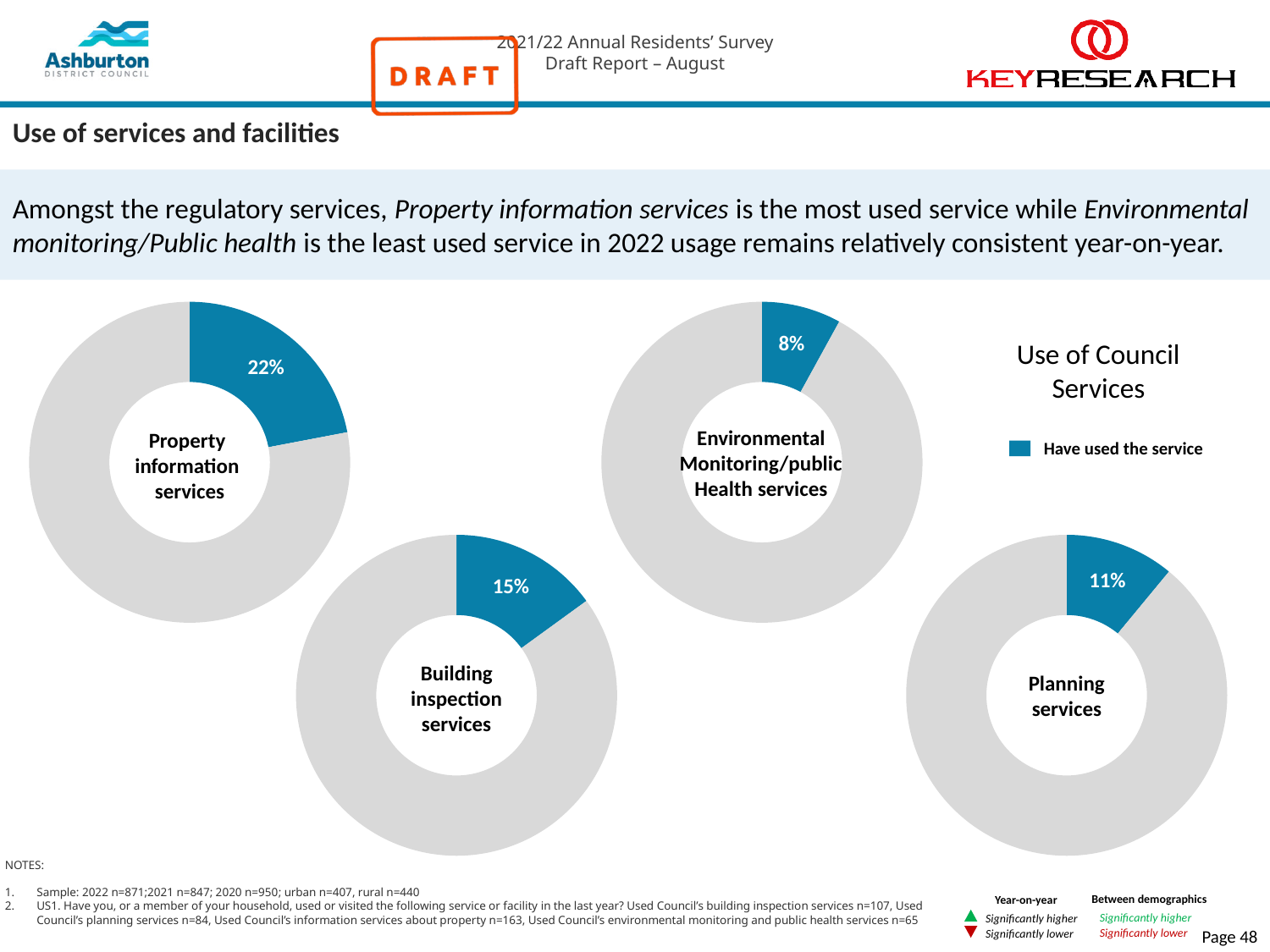
In the Planning services donut chart, what percentage have used the service? 11% Across the four donut charts, which service has the highest percentage of residents who have used it? Property information services Across the four donut charts, which service has the lowest percentage of residents who have used it? Environmental Monitoring/public Health services Which is larger: the percentage in the Building inspection services chart or the percentage in the Planning services chart? Building inspection services In the Environmental Monitoring/public Health services donut chart, what percentage have used the service? 8% What is the legend entry shown next to the blue colour in the 'Use of Council Services' legend? Have used the service In the Property information services donut chart, what percentage have used the service? 22% What is the difference in percentage points between the Building inspection services chart and the Environmental Monitoring/public Health services chart? 7 How many donut charts are shown on the slide? 4 What type of chart is used to show use of each Council service on the slide? Donut (pie) chart What is the difference in percentage points between the Property information services chart and the Planning services chart? 11 In the Building inspection services donut chart, what percentage have used the service? 15%